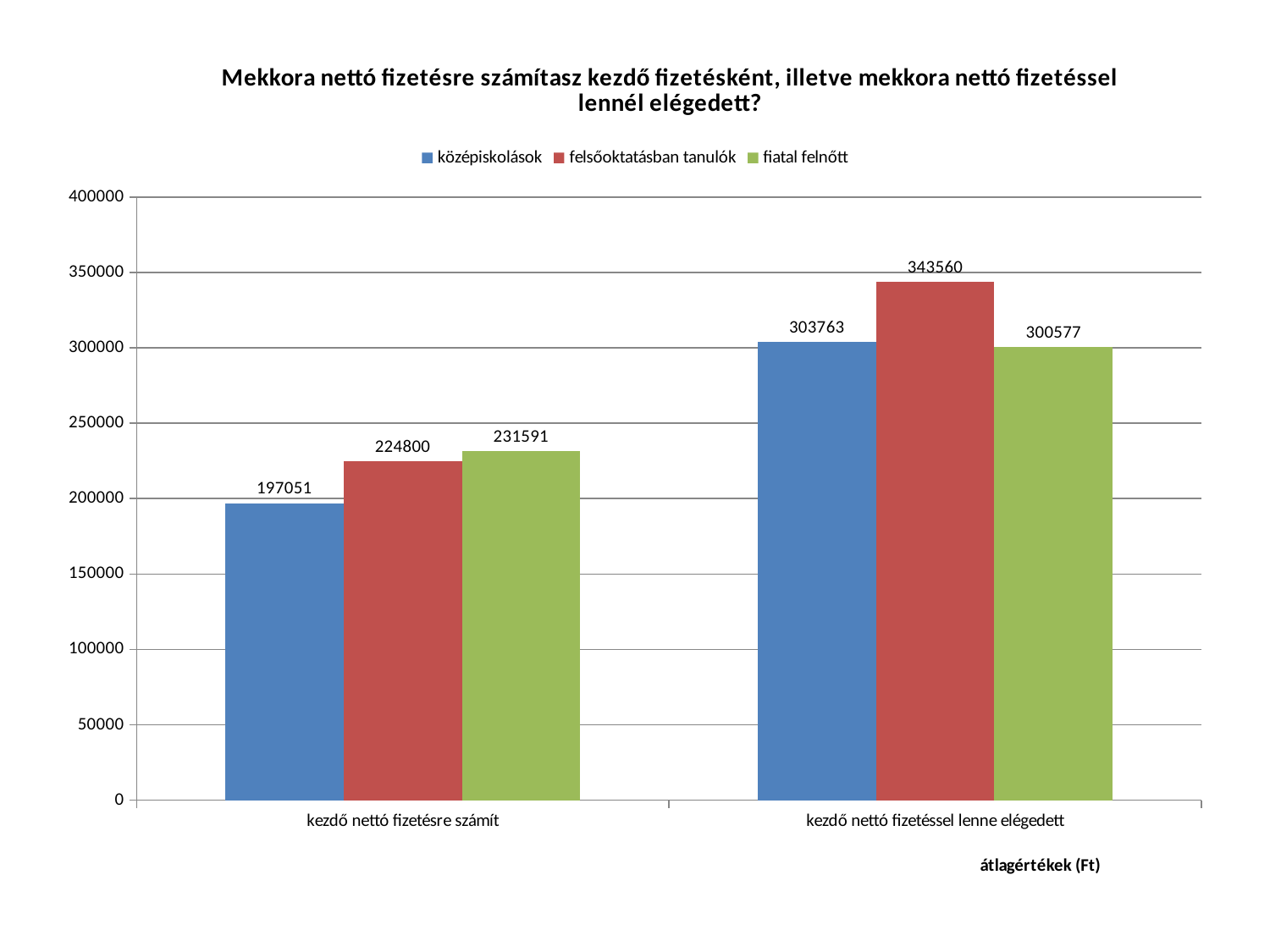
How many categories are shown on the x axis? 2 What value is shown for középiskolások in the category 'kezdő nettó fizetésre számít'? 197051 Which series has the highest value in the category 'kezdő nettó fizetéssel lenne elégedett'? felsőoktatásban tanulók Which series has the lowest value in the category 'kezdő nettó fizetésre számít'? középiskolások Which is larger: the középiskolások value for 'kezdő nettó fizetésre számít' or the középiskolások value for 'kezdő nettó fizetéssel lenne elégedett'? kezdő nettó fizetéssel lenne elégedett What value is shown for fiatal felnőtt in the category 'kezdő nettó fizetésre számít'? 231591 What value is shown for felsőoktatásban tanulók in the category 'kezdő nettó fizetéssel lenne elégedett'? 343560 Is the fiatal felnőtt value for 'kezdő nettó fizetésre számít' greater or less than 250000? less What is the difference between the felsőoktatásban tanulók and középiskolások values in the category 'kezdő nettó fizetéssel lenne elégedett'? 39797 What kind of chart is shown on the slide? bar chart How many series does the legend list? 3 What is the difference between the fiatal felnőtt and felsőoktatásban tanulók values in the category 'kezdő nettó fizetésre számít'? 6791